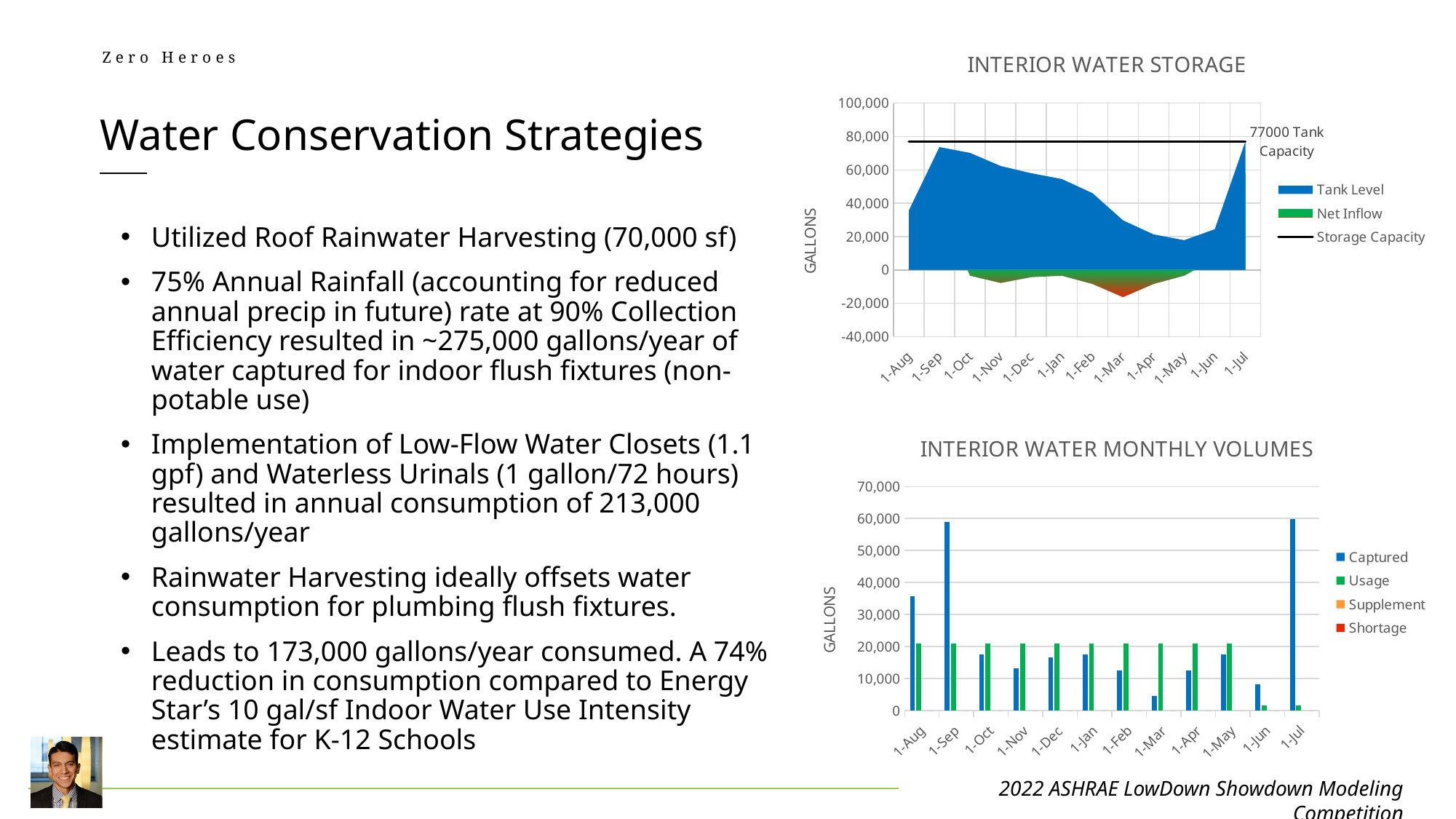
In the INTERIOR WATER MONTHLY VOLUMES chart, which is larger for 1-Mar, Captured or Usage? Usage In the INTERIOR WATER STORAGE chart, does the Tank Level rise or fall from 1-Sep to 1-May? fall In the INTERIOR WATER MONTHLY VOLUMES chart, which month has the lowest Captured value? 1-Mar How many months are shown on the x axis of the INTERIOR WATER MONTHLY VOLUMES chart? 12 In the INTERIOR WATER MONTHLY VOLUMES chart, which is larger for 1-Aug, Captured or Usage? Captured How many series does the legend of the INTERIOR WATER STORAGE chart list? 3 What kind of chart is the INTERIOR WATER MONTHLY VOLUMES chart? bar chart In the INTERIOR WATER STORAGE chart, what tank capacity is annotated next to the Storage Capacity line? 77000 In the INTERIOR WATER MONTHLY VOLUMES chart, is the Captured value for 1-Sep greater or less than 50,000? greater How many series does the legend of the INTERIOR WATER MONTHLY VOLUMES chart list? 4 In the INTERIOR WATER STORAGE chart, is the Tank Level at 1-May greater or less than 40,000? less In the INTERIOR WATER MONTHLY VOLUMES chart, is the Captured value for 1-Aug greater or less than 30,000? greater